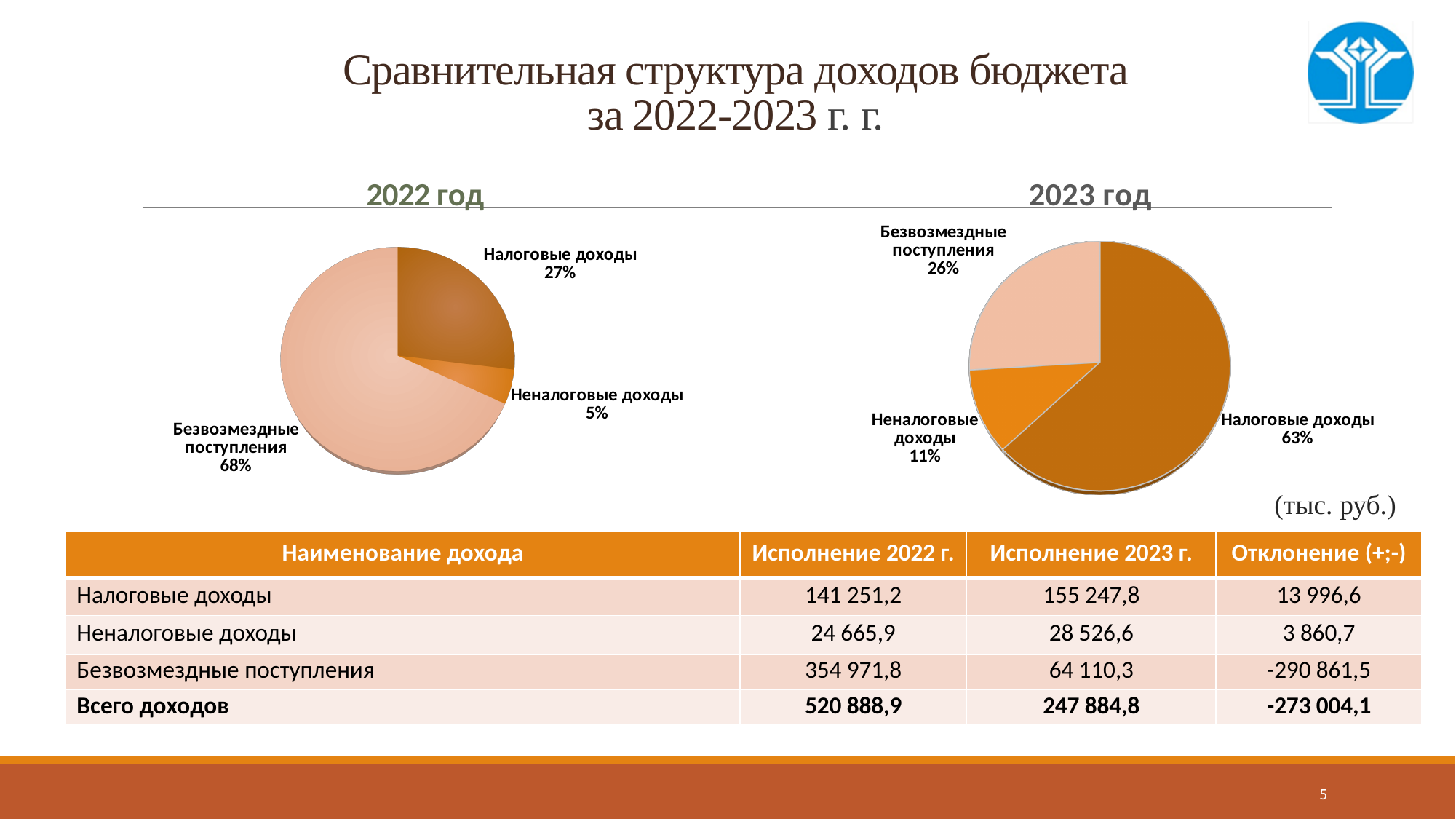
In the "2022 год" pie chart, what share does "Налоговые доходы" have? 27% In the "2023 год" pie chart, which category has the smallest slice? Неналоговые доходы In the "2023 год" pie chart, which is larger: "Налоговые доходы" or "Безвозмездные поступления"? Налоговые доходы In the "2023 год" pie chart, what share does "Неналоговые доходы" have? 11% In the "2022 год" pie chart, what share does "Безвозмездные поступления" have? 68% In the "2022 год" pie chart, what is the difference in percentage points between "Безвозмездные поступления" and "Налоговые доходы"? 41 What type of chart is used for "2022 год"? Pie chart In the "2022 год" pie chart, which category has the largest slice? Безвозмездные поступления How many slices does the "2023 год" pie chart have? 3